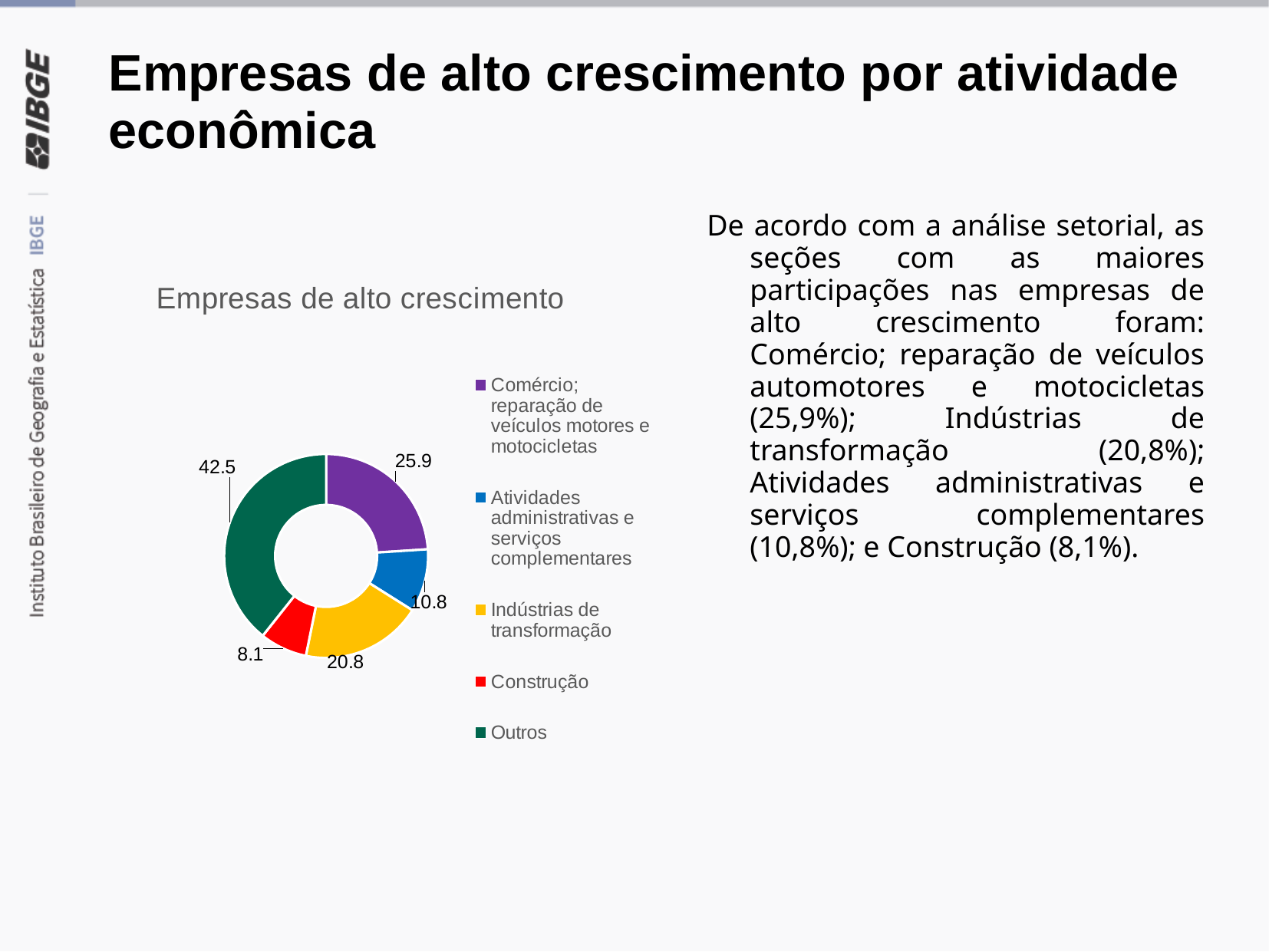
What kind of chart is shown on the slide? Doughnut chart What is the difference between the values for Comércio; reparação de veículos motores e motocicletas and Indústrias de transformação? 5.1 What is the value shown for Atividades administrativas e serviços complementares? 10.8 How many categories are shown in the chart? 5 What is the value shown for Indústrias de transformação? 20.8 Which category has the smallest share of the chart? Construção What is the value shown for Construção? 8.1 Which category has the largest share of the chart? Outros What is the value shown for Outros in the chart? 42.5 What colour represents Construção in the chart? Red Which is larger, the value for Atividades administrativas e serviços complementares or the value for Construção? Atividades administrativas e serviços complementares What is the title of the chart? Empresas de alto crescimento